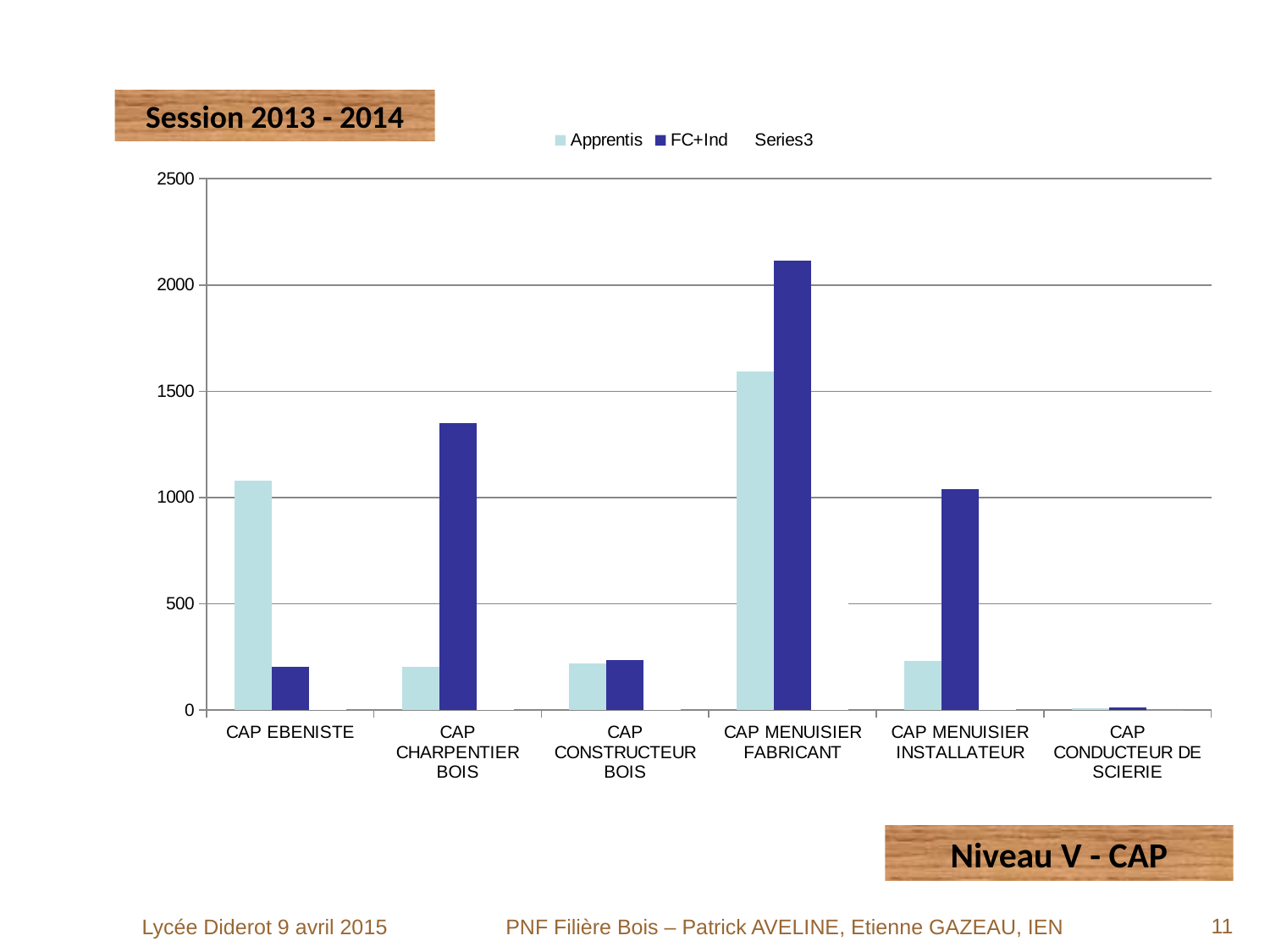
How many categories are shown on the x axis? 6 What kind of chart is shown on the slide? bar chart What session is named in the label above the chart? Session 2013 - 2014 How many series does the legend list? 3 Is the FC+Ind value for CAP MENUISIER INSTALLATEUR greater or less than 1500? less For CAP EBENISTE, which series has the larger value, Apprentis or FC+Ind? Apprentis Is the Apprentis value for CAP EBENISTE greater or less than 1000? greater For CAP CHARPENTIER BOIS, which series has the larger value, Apprentis or FC+Ind? FC+Ind Which category has the highest Apprentis value? CAP MENUISIER FABRICANT Which category has the lowest Apprentis value? CAP CONDUCTEUR DE SCIERIE Is the FC+Ind value for CAP MENUISIER FABRICANT greater or less than 2000? greater Which category has the highest FC+Ind value? CAP MENUISIER FABRICANT